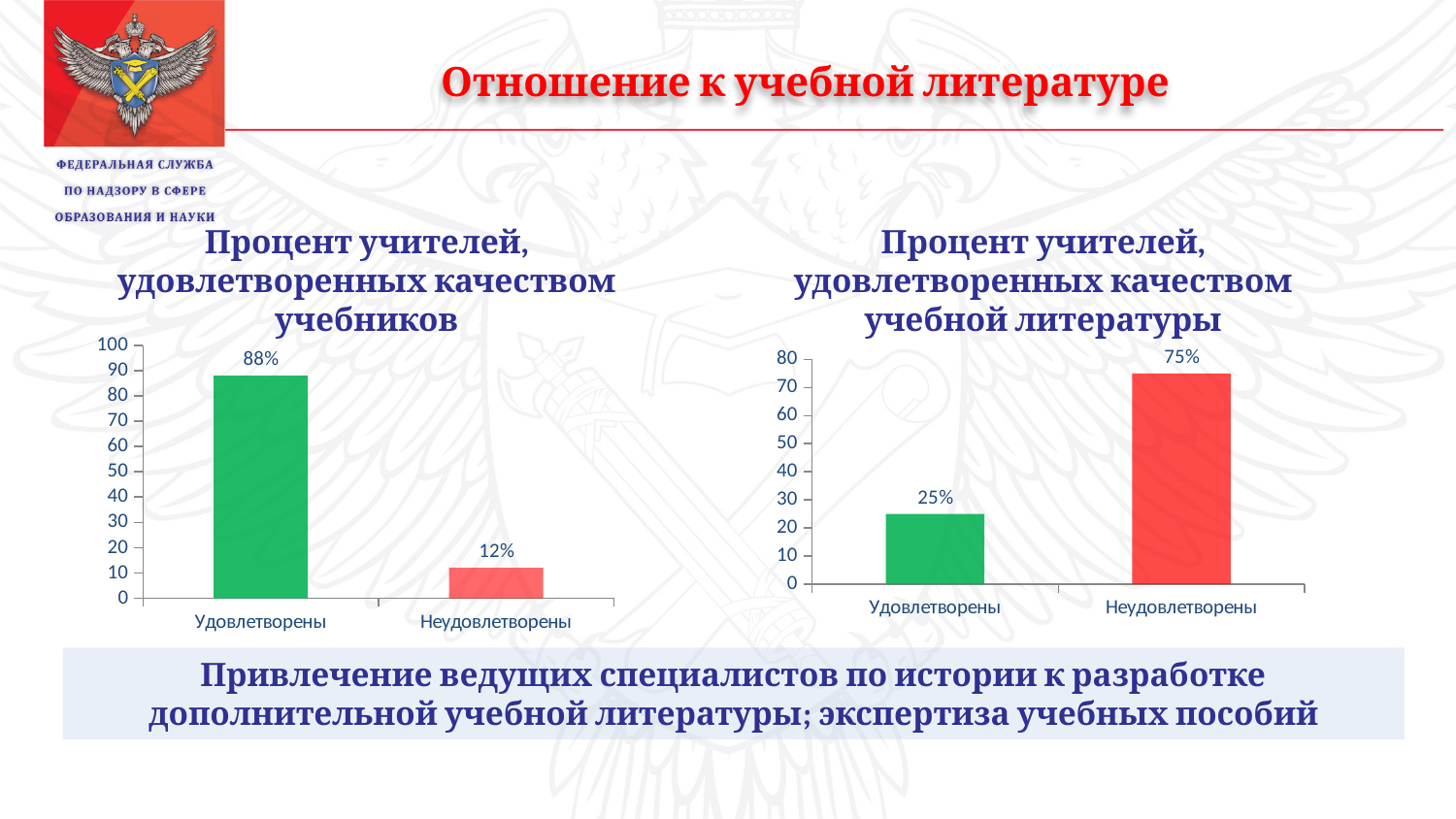
In the right chart (Процент учителей, удовлетворенных качеством учебной литературы), what is the value for Неудовлетворены? 75% In the left chart (Процент учителей, удовлетворенных качеством учебников), what is the value for Удовлетворены? 88% What type of chart is the right chart? Bar chart In the right chart, which is larger: Удовлетворены or Неудовлетворены? Неудовлетворены In the right chart (Процент учителей, удовлетворенных качеством учебной литературы), what is the value for Удовлетворены? 25% In the left chart, what colour is the bar for Удовлетворены? Green In the right chart, which category has the lowest value? Удовлетворены How many categories does the left chart show? 2 In the right chart, what is the difference between Неудовлетворены and Удовлетворены? 50% In the left chart (Процент учителей, удовлетворенных качеством учебников), what is the value for Неудовлетворены? 12% In the left chart, what is the difference between Удовлетворены and Неудовлетворены? 76% In the left chart, which category has the highest value? Удовлетворены